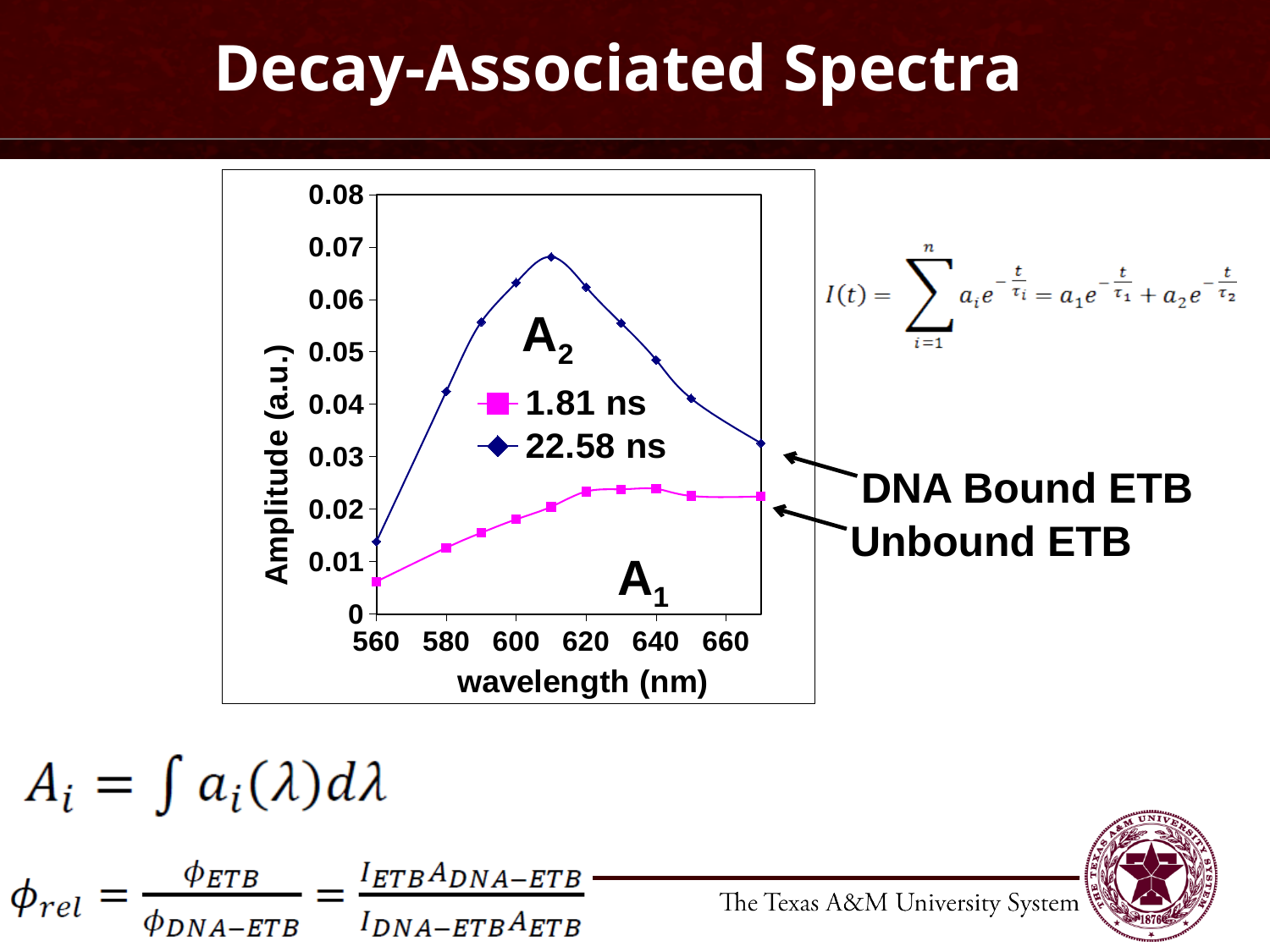
Is the amplitude of the 1.81 ns series at 640 nm greater or less than 0.02? greater What is the label of the x axis of the chart? wavelength (nm) What kind of chart is shown on the slide? line chart Which series reaches the higher peak amplitude, 1.81 ns or 22.58 ns? 22.58 ns Is the amplitude of the 22.58 ns series at 670 nm greater or less than 0.03? greater Is the amplitude of the 1.81 ns series at 560 nm greater or less than 0.01? less How does the amplitude of the 22.58 ns series change as wavelength increases from 560 nm to 670 nm? rises to a peak at 610 nm, then falls How many series does the chart legend list? 2 Does the amplitude of the 1.81 ns series rise or fall between 560 nm and 640 nm? rises At which wavelength does the 22.58 ns series reach its maximum amplitude? 610 nm What are the two series named in the chart legend? 1.81 ns and 22.58 ns